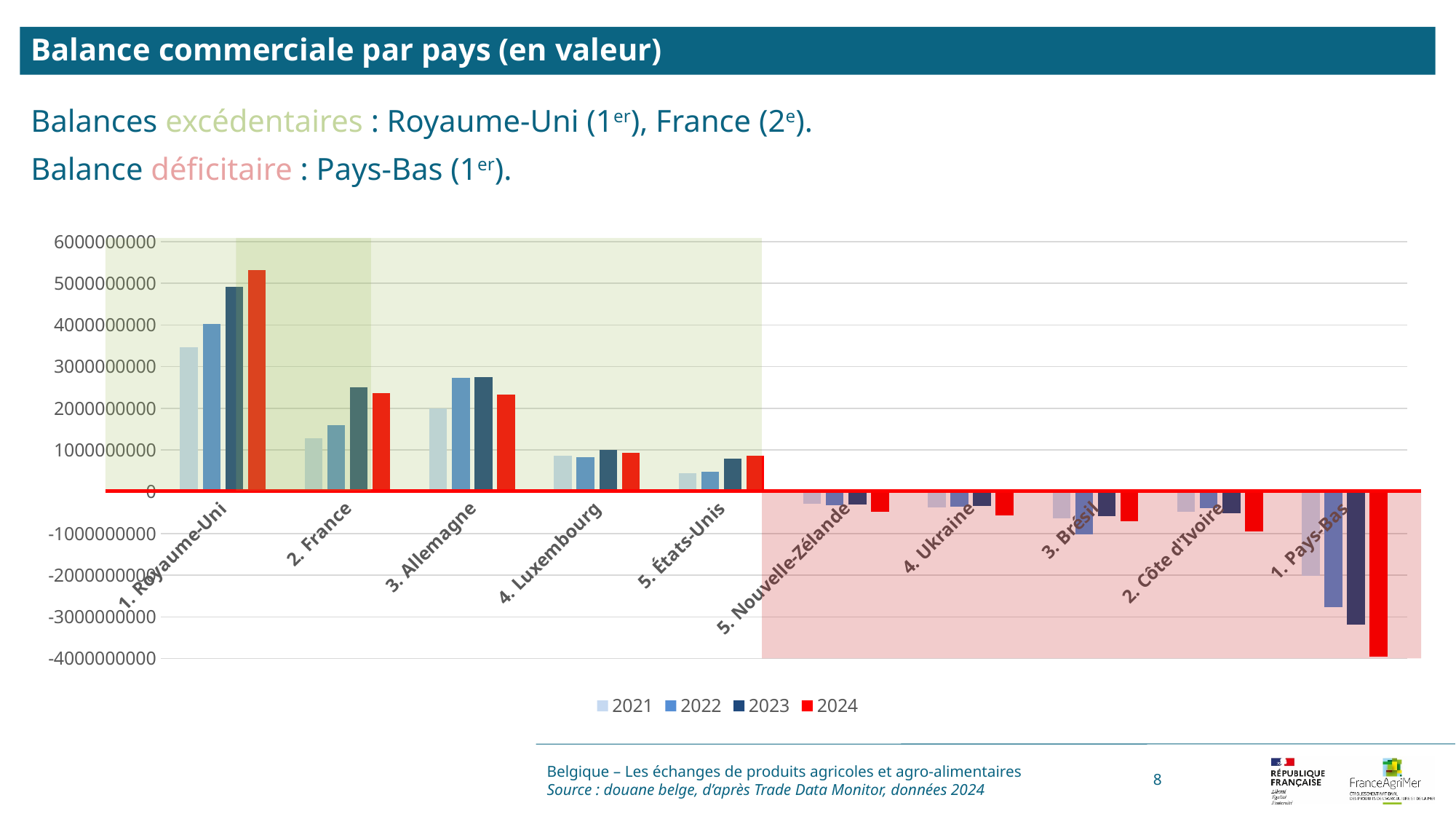
Do the values for Pays-Bas rise or fall from 2021 to 2024? fall Is the 2024 value for Pays-Bas greater or less than -3000000000? less How many series does the legend list? 4 Do the values for Royaume-Uni rise or fall from 2021 to 2024? rise Which country has the lowest 2024 value in the chart? 1. Pays-Bas Is the 2024 value for Royaume-Uni greater or less than 5000000000? greater What kind of chart is shown on the slide? bar chart Which country has the highest 2024 value in the chart? 1. Royaume-Uni How many countries are shown on the x axis of the chart? 10 What is the title of the slide containing the chart? Balance commerciale par pays (en valeur) Is the 2022 value for Allemagne greater or less than 2000000000? greater Which is larger, the 2024 value for Royaume-Uni or the 2024 value for France? Royaume-Uni